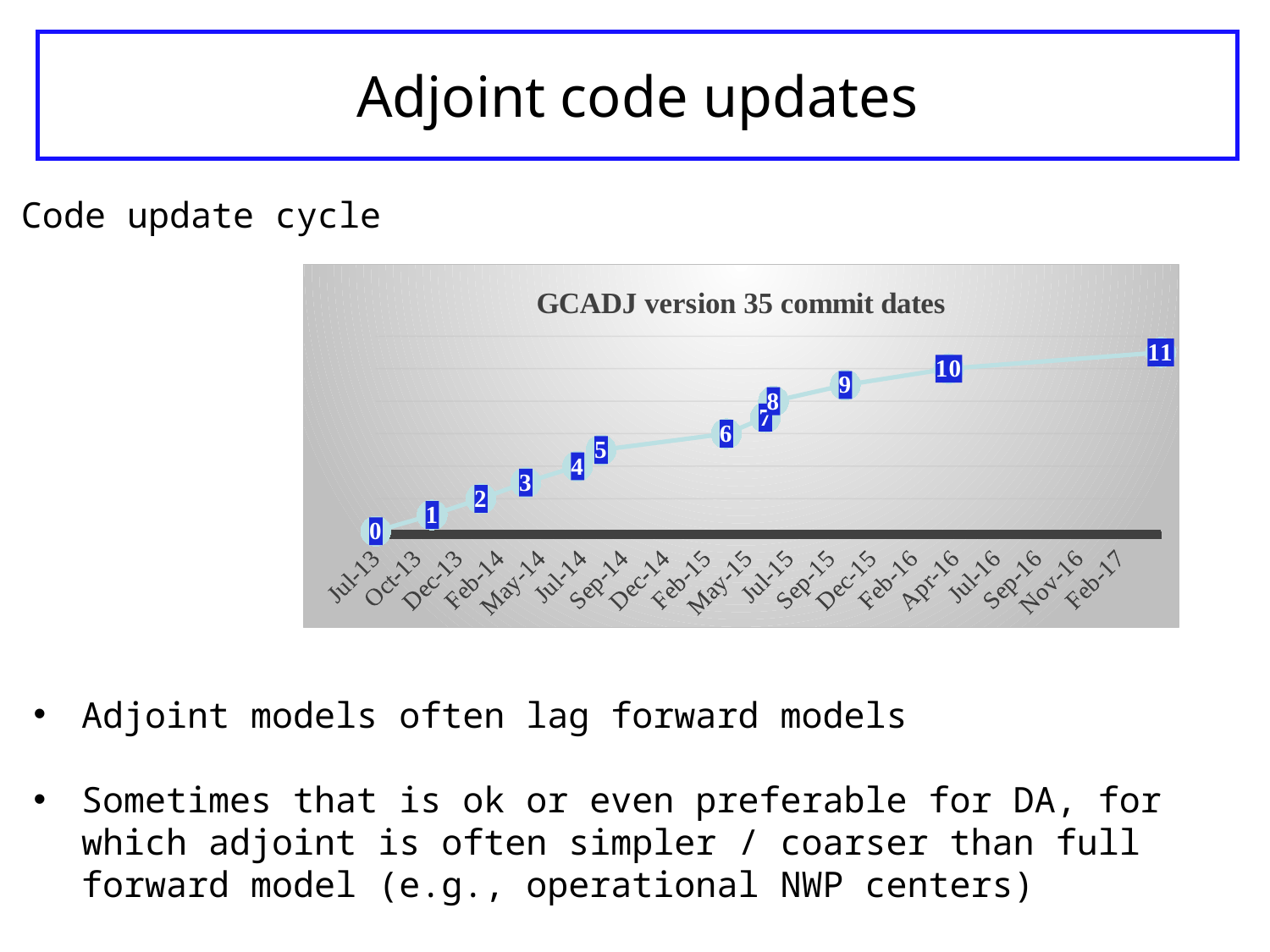
Which data label marks the lowest point on the line? 0 Which data label marks the highest point on the line? 11 Do the plotted values rise or fall from left to right along the x axis? rise What is the data label on the rightmost point of the line? 11 What is the title of the chart? GCADJ version 35 commit dates How many data points are plotted on the line? 12 What is the first date label on the x axis? Jul-13 What kind of chart is shown on the slide? line chart What is the data label on the leftmost point of the line? 0 What is the difference between the data labels of the last and first points on the line? 11 Is the point labelled 10 higher or lower than the point labelled 6? higher